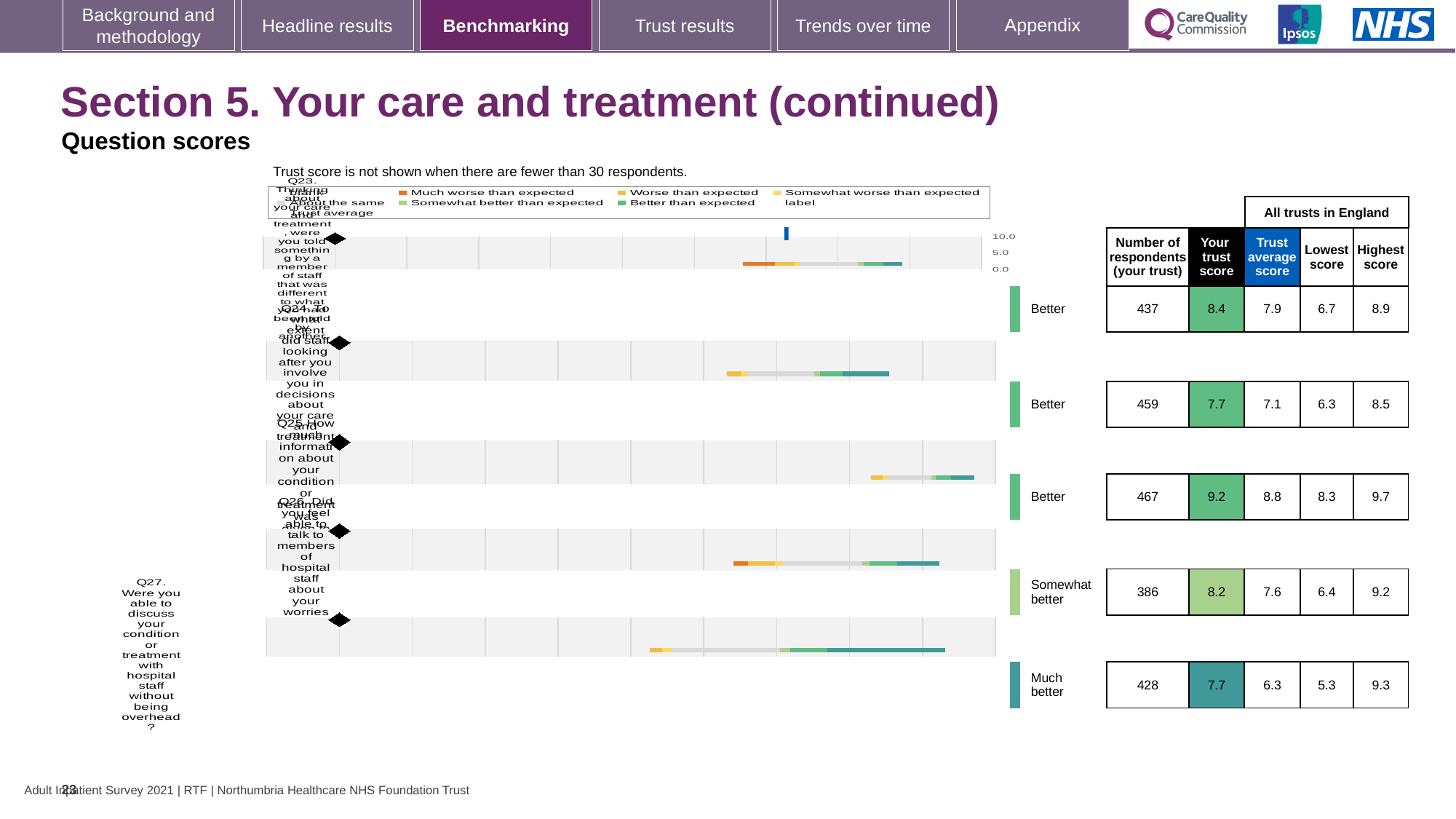
Which question is rated 'Somewhat better'? Q26 For Q26, which is larger: the 'Your trust score' or the 'Trust average score'? Your trust score Which question has the highest 'Your trust score'? Q25 How many respondents are shown for Q27? 428 Which question has the lowest 'Trust average score'? Q27 What is the 'Your trust score' value for Q23? 8.4 What is the difference between the 'Your trust score' and the 'Trust average score' for Q23? 0.5 What kind of chart is used to show the question scores on this slide? bar chart What is the 'Lowest score' value shown for Q24? 6.3 What is the 'Highest score' value shown for Q25? 9.7 How many questions (categories) are plotted in the chart? 5 Which benchmark category is Q27 placed in? Much better